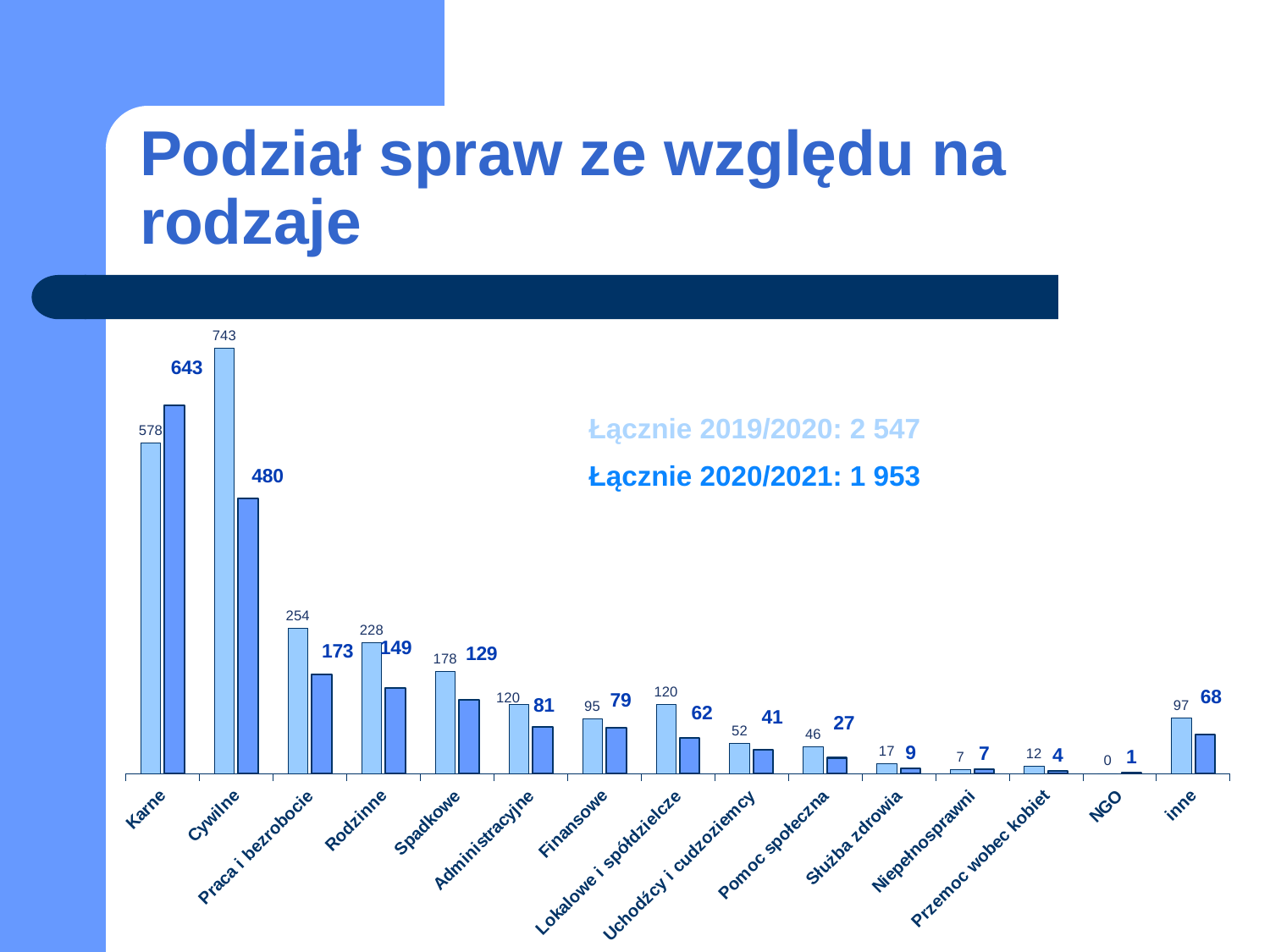
What is the value of the dark blue (2020/2021) bar for Karne? 643 What is the title of the slide containing the chart? Podział spraw ze względu na rodzaje What is the value of the dark blue (2020/2021) bar for Praca i bezrobocie? 173 Which is larger for Karne: the light blue (2019/2020) bar or the dark blue (2020/2021) bar? the dark blue (2020/2021) bar How many categories are shown on the x axis of the chart? 15 Which category has the highest light blue (2019/2020) value? Cywilne What type of chart is shown on the slide? bar chart Which category has the lowest light blue (2019/2020) value? NGO What total is given on the slide for 2020/2021? 1 953 What is the value of the light blue (2019/2020) bar for inne? 97 What is the value of the light blue (2019/2020) bar for Cywilne? 743 What is the difference between the light blue (2019/2020) and dark blue (2020/2021) values for Cywilne? 263